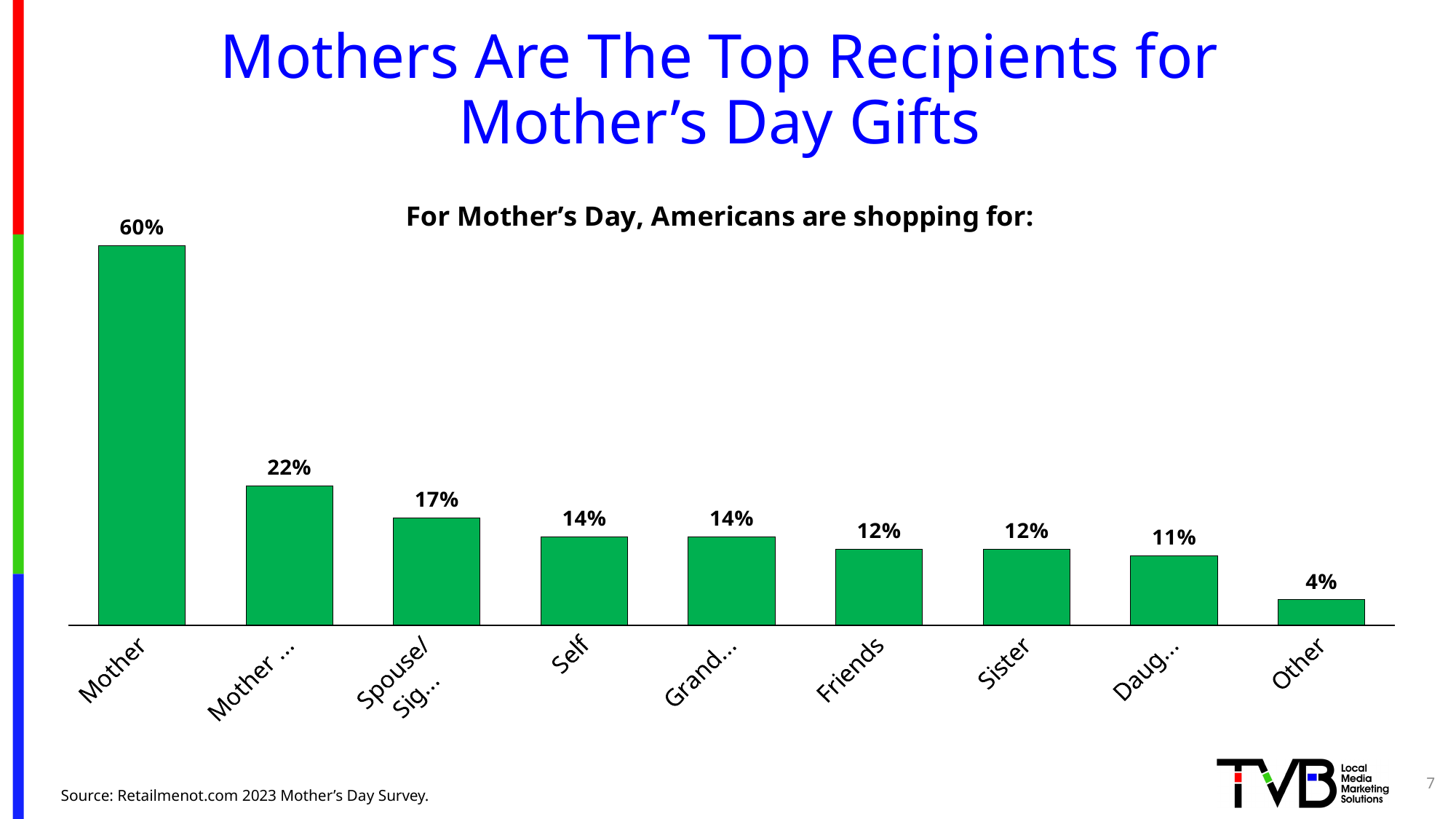
What is the difference between the values for Mother and Self? 46% Which category has the highest value? Mother What is the value for Self? 14% What is the value for Sister? 12% How many categories are shown in the chart? 9 What is the difference between the values for Friends and Other? 8% Which category has the lowest value? Other What is the value for Other? 4% What is the value for Friends? 12% Which is larger, the value for Self or the value for Sister? Self What percentage of Americans are shopping for their Mother for Mother's Day? 60% What kind of chart is shown on the slide? Bar chart